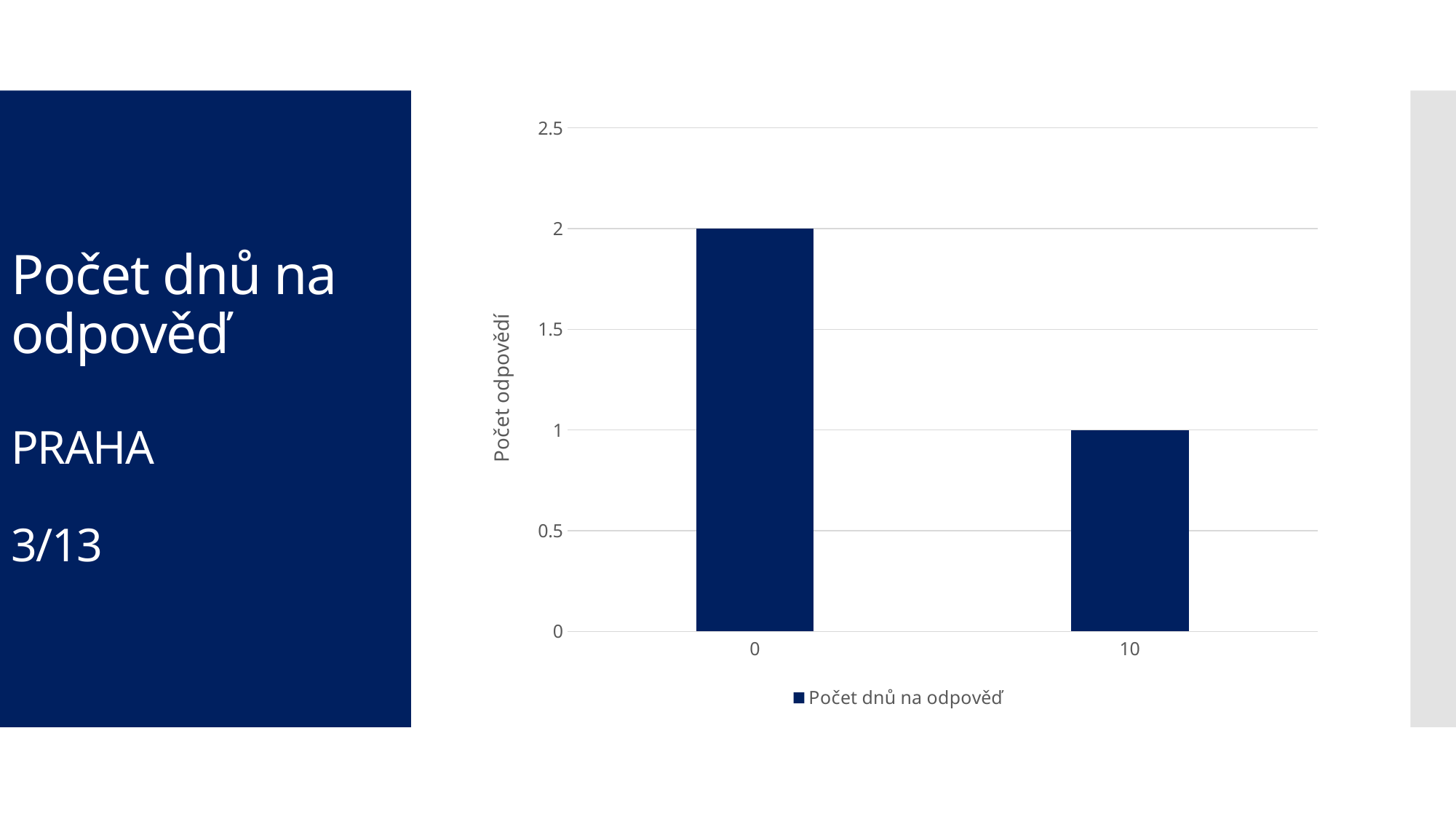
Which category has the larger value, 0 or 10? 0 Which category has the highest value? 0 What is the label of the series shown in the chart legend? Počet dnů na odpověď What kind of chart is shown on the slide? bar chart What is the difference between the values for category 0 and category 10? 1 What is the value (Počet odpovědí) for the category 10? 1 Is the value for category 0 greater or less than 1.5? greater How many categories are shown on the x axis of the chart? 2 How many series does the chart legend list? 1 Which category has the lowest value? 10 What is the value (Počet odpovědí) for the category 0? 2 Do the values rise or fall from left to right along the x axis? fall